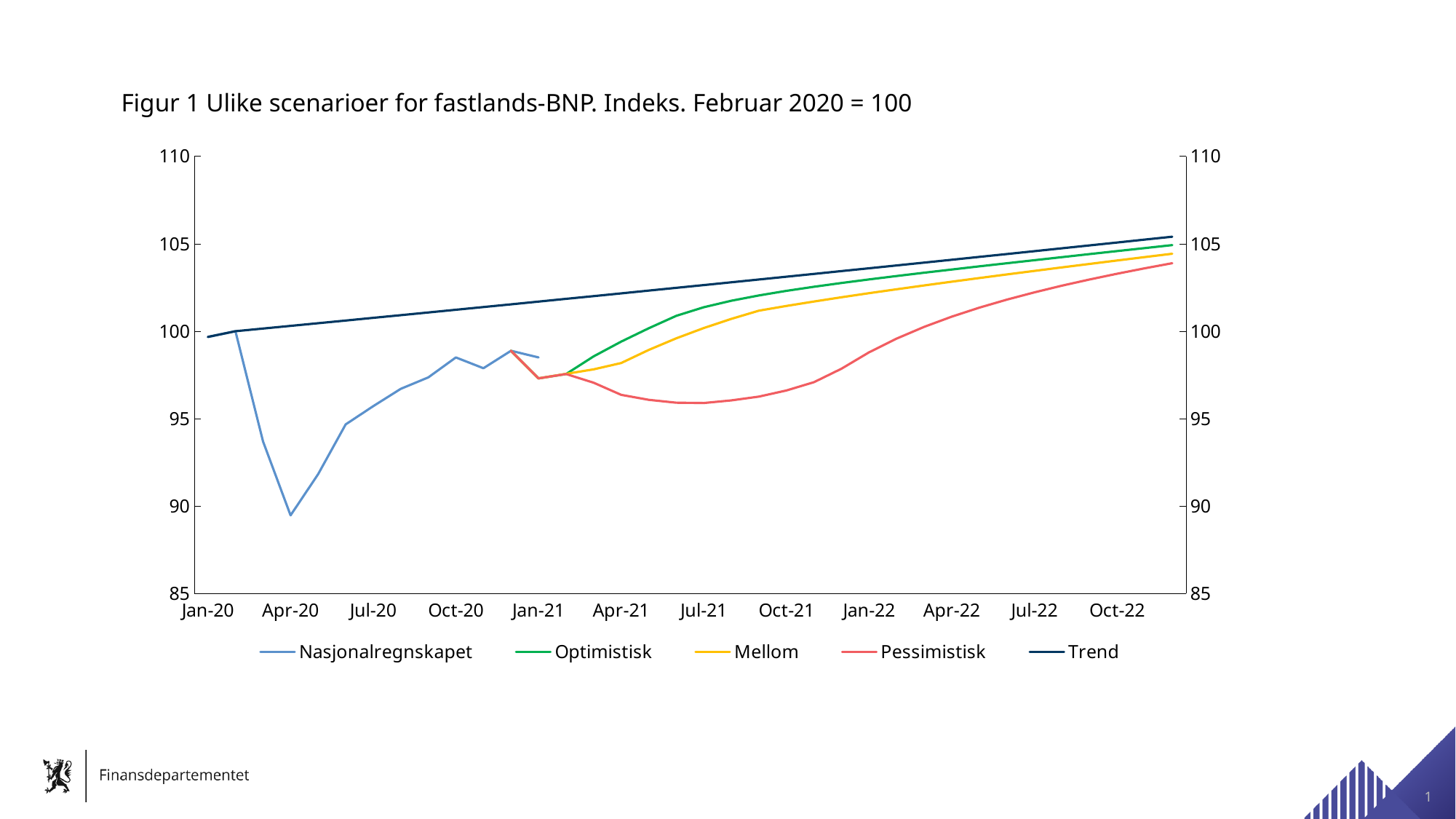
What is the title of the chart? Figur 1 Ulike scenarioer for fastlands-BNP. Indeks. Februar 2020 = 100 Which series has the lowest value at Oct-21: Optimistisk, Mellom or Pessimistisk? Pessimistisk Is the value of the Pessimistisk series at Jul-21 greater or less than 100? less Is the lowest value of the Nasjonalregnskapet series greater or less than 90? less How many series does the legend list? 5 Does the Pessimistisk series rise or fall between Jan-21 and Jul-21? fall What kind of chart is shown on the slide? line chart Does the Trend series rise or fall from Jan-20 to Oct-22? rise Is the value of the Optimistisk series at Jan-22 greater or less than 100? greater At Jul-21, which is larger, the Optimistisk series or the Mellom series? Optimistisk Which series is drawn in green in the legend? Optimistisk